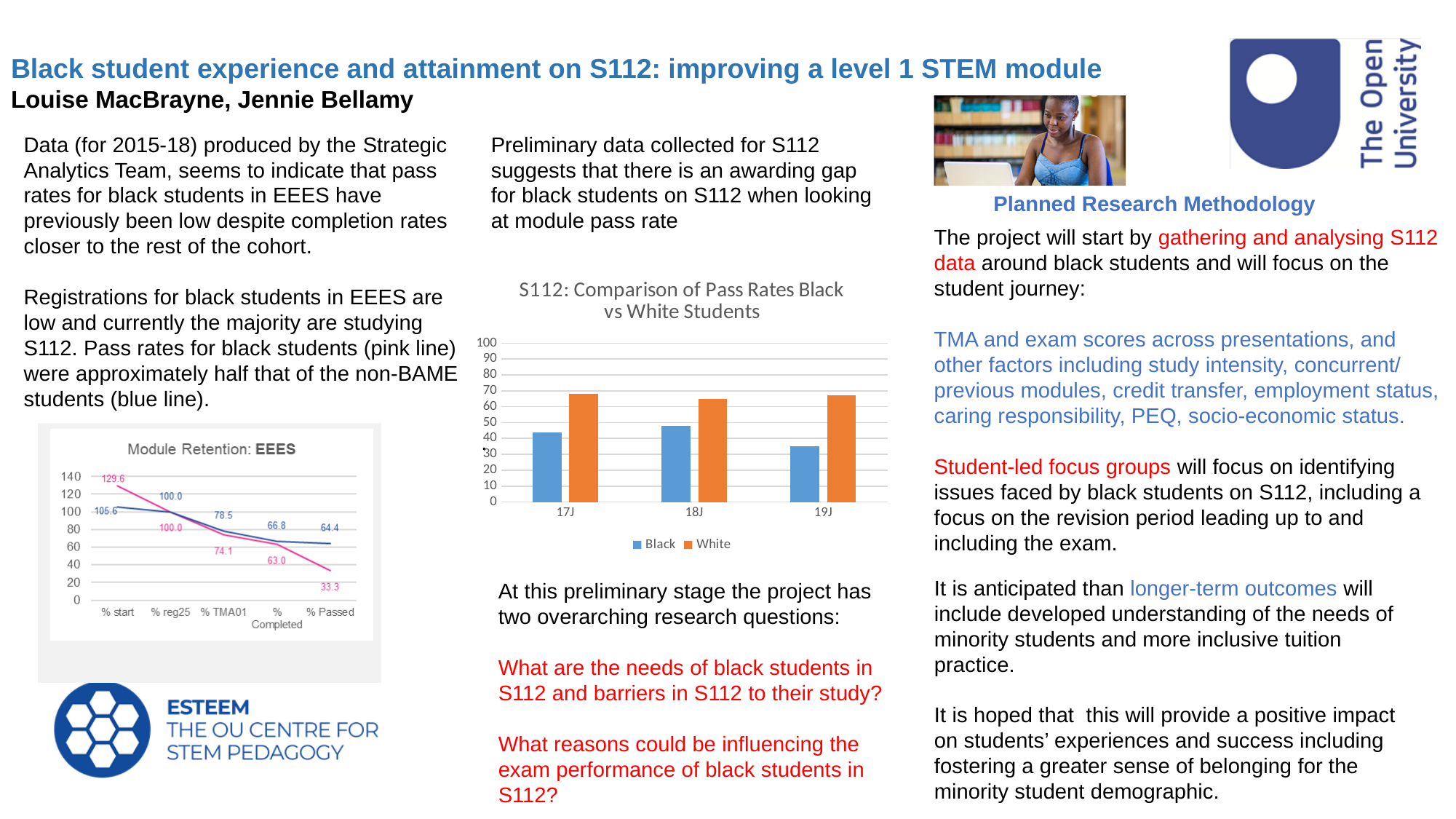
In the 'S112: Comparison of Pass Rates Black vs White Students' chart, is the value for Black students in 19J greater or less than 40? less In the 'Module Retention: EEES' chart, how many categories are shown on the x axis? 5 In the 'Module Retention: EEES' chart, what is the value of the blue line at '% Passed'? 64.4 In the 'Module Retention: EEES' chart, what is the value of the pink line at '% start'? 129.6 In the 'S112: Comparison of Pass Rates Black vs White Students' chart, which series is larger in 18J, Black or White? White In the 'Module Retention: EEES' chart, at which category does the pink line reach its lowest value? % Passed In the 'Module Retention: EEES' chart, what is the value of the pink line at '% Passed'? 33.3 In the 'S112: Comparison of Pass Rates Black vs White Students' chart, is the value for White students in 17J greater or less than 60? greater In the 'S112: Comparison of Pass Rates Black vs White Students' chart, how many series does the legend list? 2 In the 'Module Retention: EEES' chart, what is the difference between the blue line and the pink line at '% Passed'? 31.1 In the 'Module Retention: EEES' chart, does the pink line rise or fall from '% start' to '% Passed'? Fall What type of chart is 'S112: Comparison of Pass Rates Black vs White Students'? Bar chart